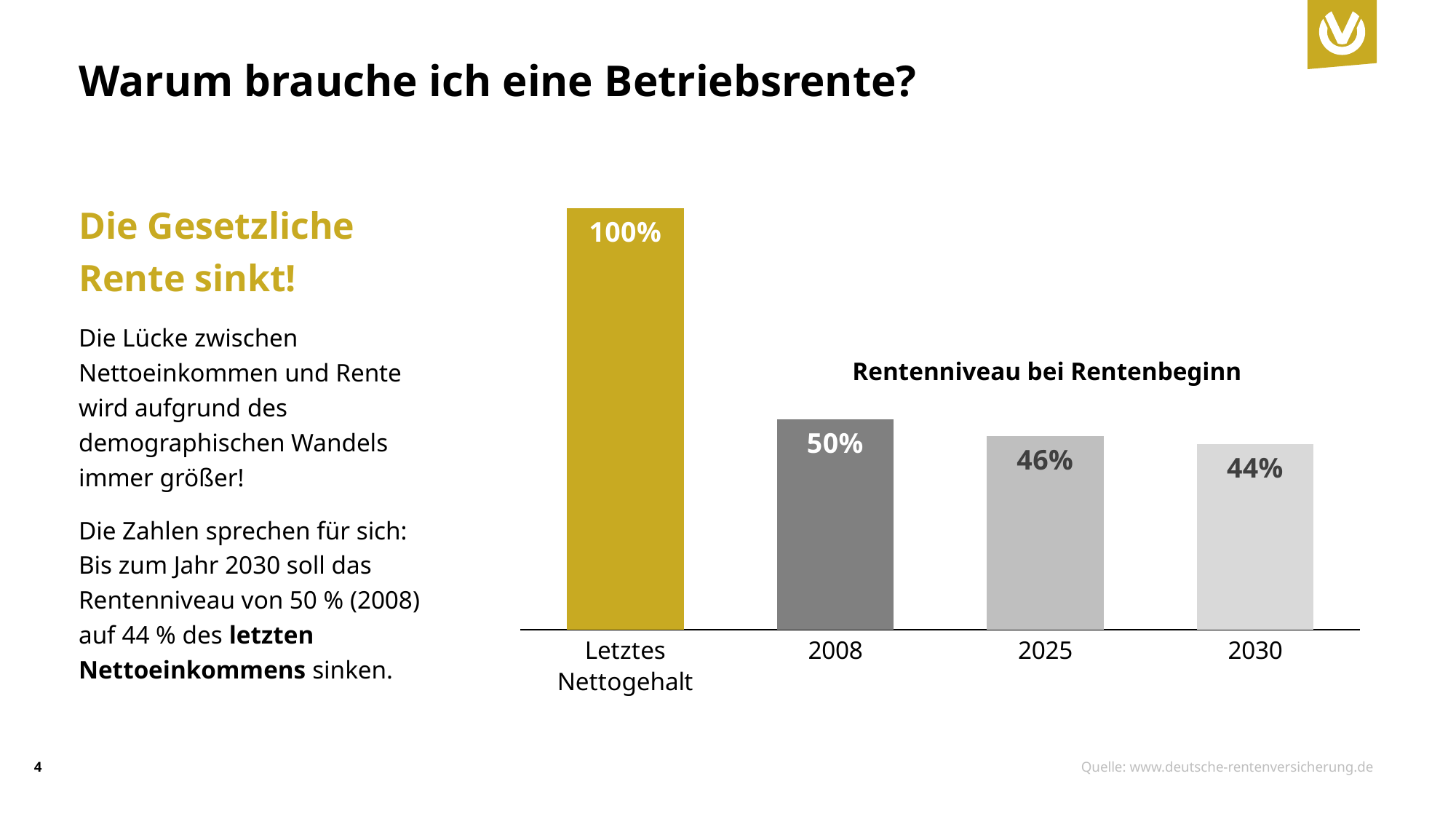
Which category has the lowest value? 2030 Which is larger, the value for 2025 or the value for 2030? 2025 What is the difference between the values for 2008 and 2030? 6% What is the value for 2008? 50% What kind of chart is shown on the slide? Bar chart Do the values rise or fall from 2008 to 2030? Fall What value is shown for 'Letztes Nettogehalt'? 100% Which category has the highest value? Letztes Nettogehalt What is the value for 2030? 44% What is the difference between the values for 'Letztes Nettogehalt' and 2008? 50% What is the value for 2025? 46% How many bars are shown in the chart? 4